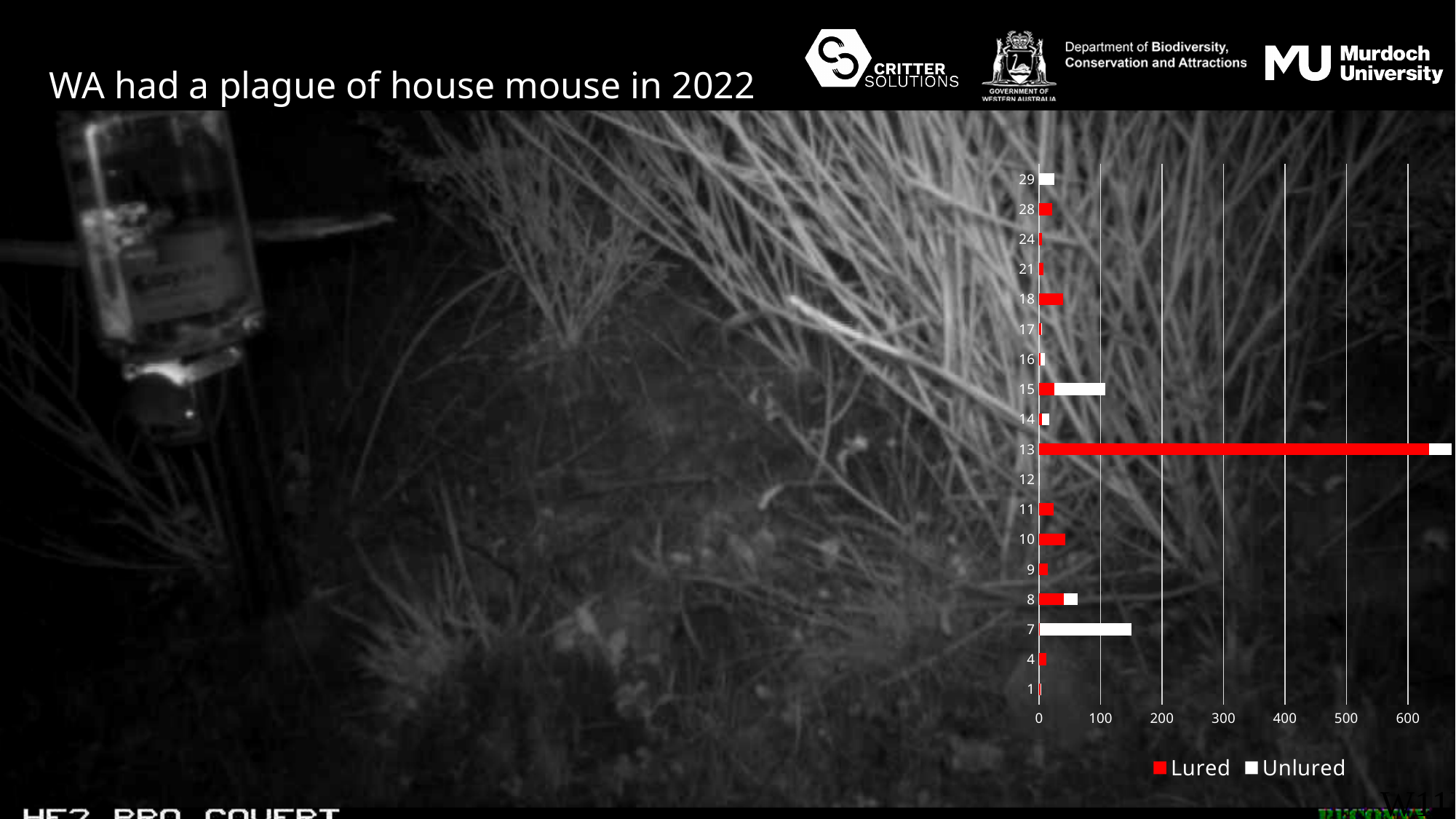
For category 7, which series has the larger value, Lured or Unlured? Unlured Which category has the highest Lured value? 13 Which category has the longest Unlured bar? 7 How many series does the chart legend list? 2 Is the Lured value for category 10 greater or less than 100? less Is the Unlured value for category 7 greater or less than 200? less For category 13, which series has the larger value, Lured or Unlured? Lured What kind of chart is shown on the slide? bar chart What is the title text on the slide above the chart? WA had a plague of house mouse in 2022 Is the Lured value for category 13 greater or less than 500? greater Which colour represents the Lured series in the chart? red How many categories are shown on the chart's vertical axis? 18